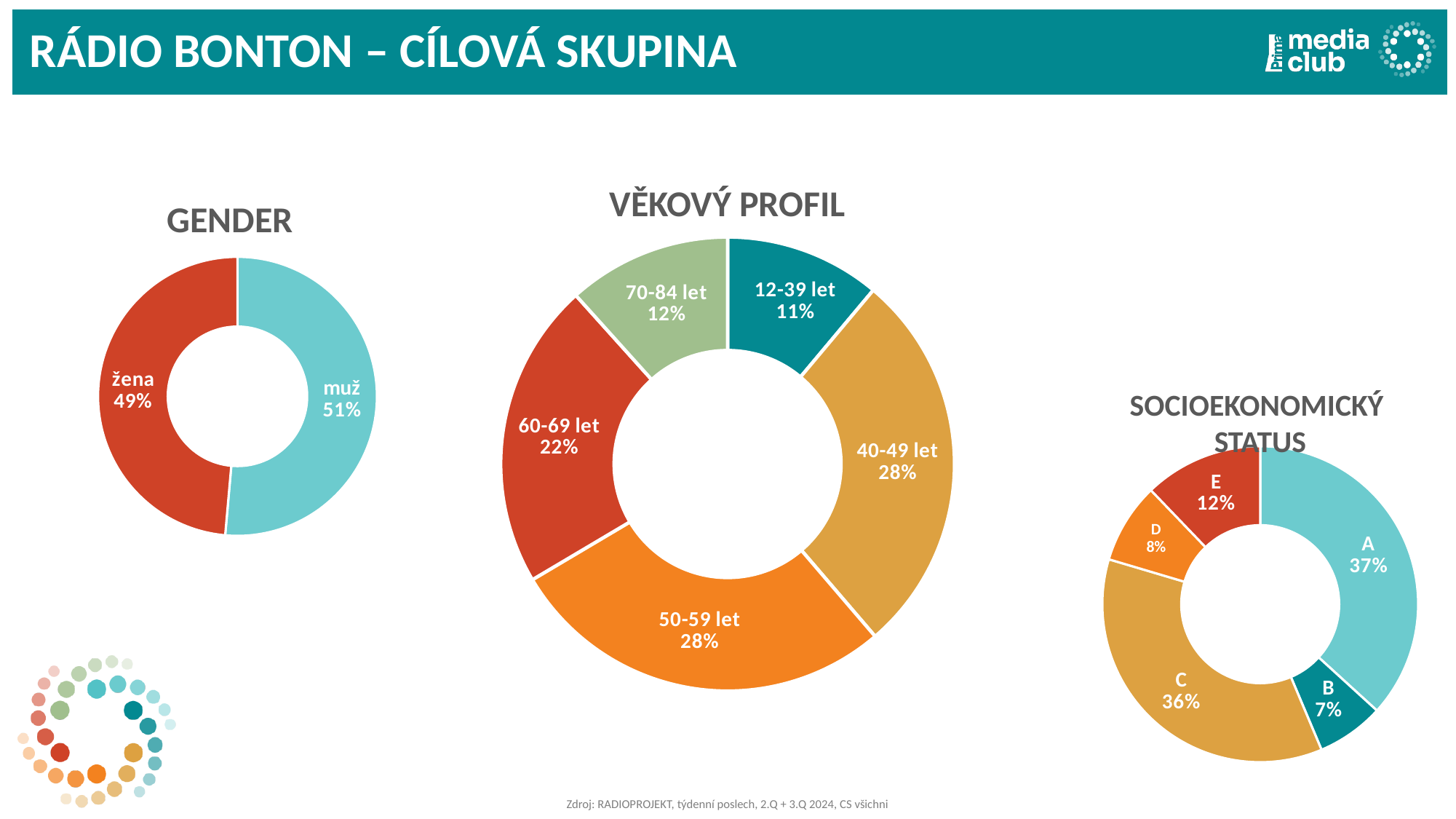
In the GENDER chart, which category has the larger share, žena or muž? muž In the VĚKOVÝ PROFIL chart, what is the difference between the shares for 60-69 let and 70-84 let? 10% In the GENDER chart, what share is labelled for muž? 51% In the VĚKOVÝ PROFIL chart, which age group has the smallest share? 12-39 let What kind of chart is the GENDER chart? Doughnut (pie) chart In the GENDER chart, what share is labelled for žena? 49% In the SOCIOEKONOMICKÝ STATUS chart, what share is labelled for D? 8% In the VĚKOVÝ PROFIL chart, what share is labelled for 50-59 let? 28% In the VĚKOVÝ PROFIL chart, how many age groups are shown? 5 In the SOCIOEKONOMICKÝ STATUS chart, which category has the smallest share? B In the SOCIOEKONOMICKÝ STATUS chart, which category has the largest share? A In the VĚKOVÝ PROFIL chart, what share is labelled for 60-69 let? 22%